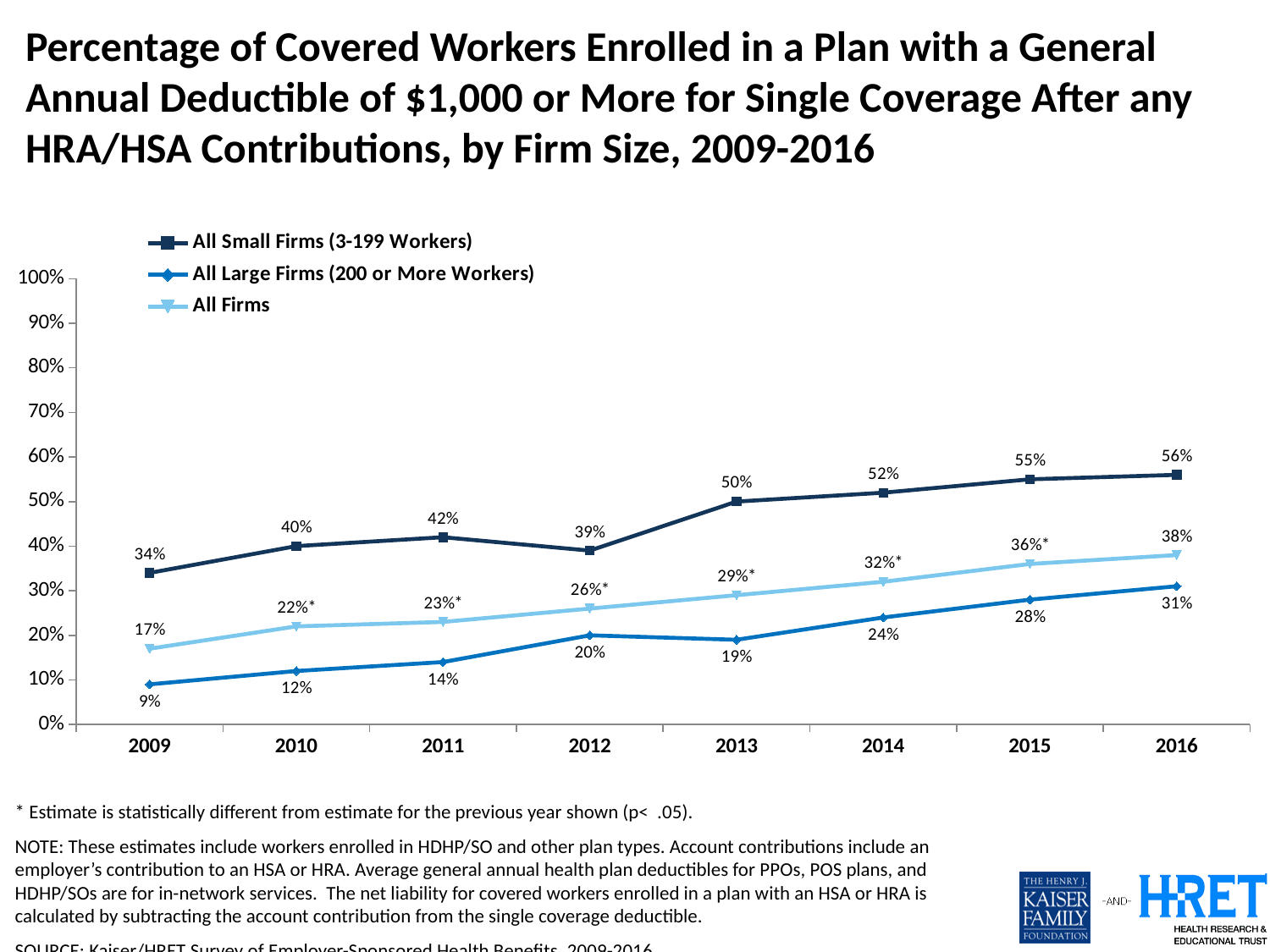
Does the value for All Firms rise or fall from 2009 to 2016? rise In which year is the value for All Large Firms (200 or More Workers) lowest? 2009 In which year is the value for All Small Firms (3-199 Workers) highest? 2016 What is the difference between the All Small Firms and All Large Firms values in 2016? 25% How many series does the legend list? 3 How many years are shown on the x axis? 8 What is the value for All Small Firms (3-199 Workers) in 2016? 56% What kind of chart is shown on the slide? line chart Is the value for All Small Firms (3-199 Workers) in 2013 greater or less than 40%? greater What is the value for All Large Firms (200 or More Workers) in 2009? 9% Which is larger in 2012: the value for All Small Firms (3-199 Workers) or All Firms? All Small Firms (3-199 Workers) What is the value for All Firms in 2013? 29%*